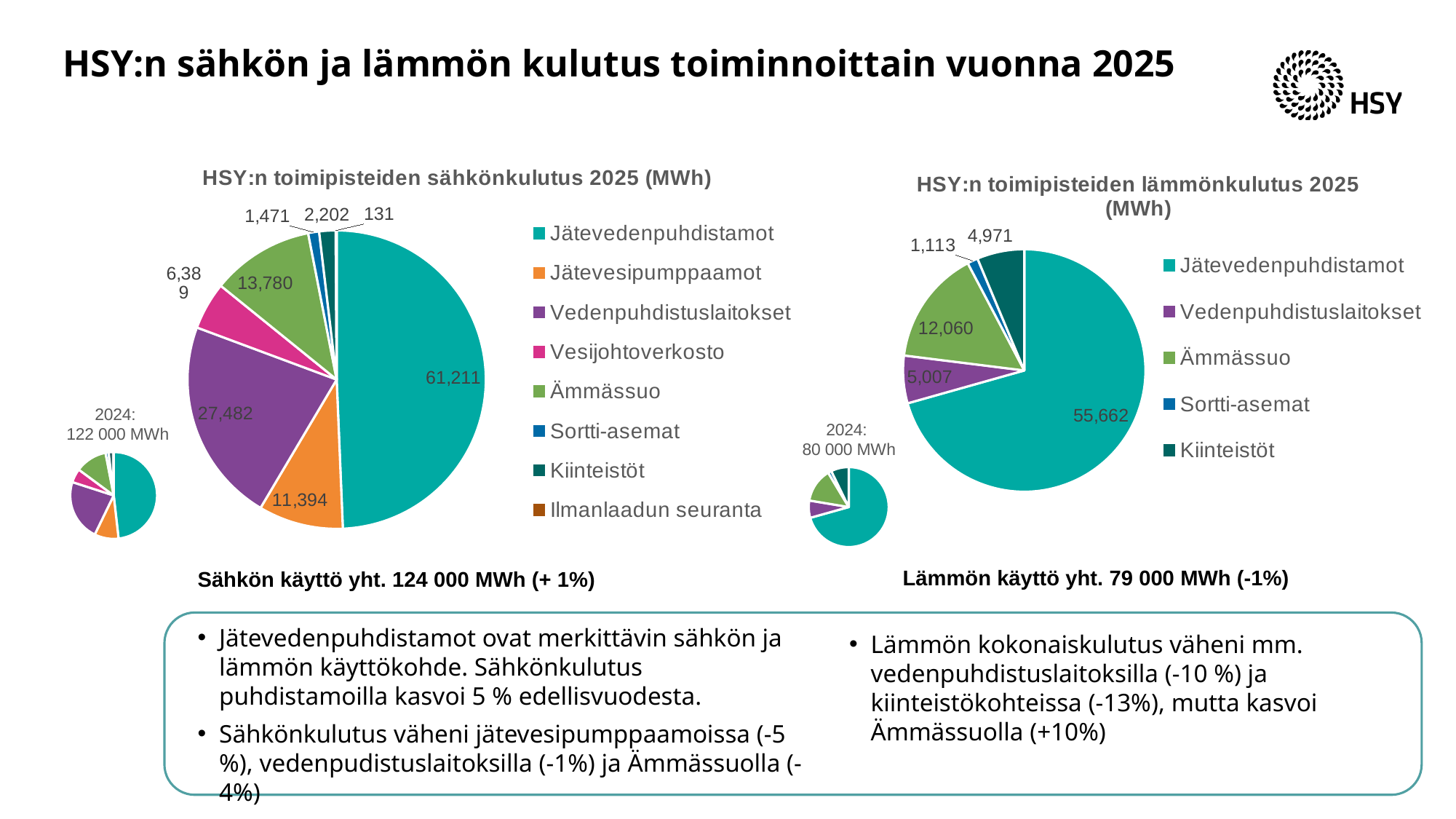
According to the small 2024 pie next to the electricity chart on the left, what was the 2024 electricity consumption? 122 000 MWh In the chart 'HSY:n toimipisteiden lämmönkulutus 2025 (MWh)', what is the difference between Jätevedenpuhdistamot and Ämmässuo? 43,602 In the chart 'HSY:n toimipisteiden lämmönkulutus 2025 (MWh)', which category has the smallest slice? Sortti-asemat How many categories does the legend of the chart 'HSY:n toimipisteiden sähkönkulutus 2025 (MWh)' list? 8 In the chart 'HSY:n toimipisteiden lämmönkulutus 2025 (MWh)', what is the value for Ämmässuo? 12,060 In the chart 'HSY:n toimipisteiden sähkönkulutus 2025 (MWh)', what is the difference between Vedenpuhdistuslaitokset and Jätevesipumppaamot? 16,088 In the chart 'HSY:n toimipisteiden lämmönkulutus 2025 (MWh)', which is larger, Ämmässuo or Vedenpuhdistuslaitokset? Ämmässuo In the chart 'HSY:n toimipisteiden sähkönkulutus 2025 (MWh)', what is the value for Kiinteistöt? 2,202 In the chart 'HSY:n toimipisteiden lämmönkulutus 2025 (MWh)', what is the value for Sortti-asemat? 1,113 In the chart 'HSY:n toimipisteiden sähkönkulutus 2025 (MWh)', what is the value for Jätevedenpuhdistamot? 61,211 What type of chart is 'HSY:n toimipisteiden lämmönkulutus 2025 (MWh)'? Pie chart In the chart 'HSY:n toimipisteiden sähkönkulutus 2025 (MWh)', which category has the largest slice? Jätevedenpuhdistamot